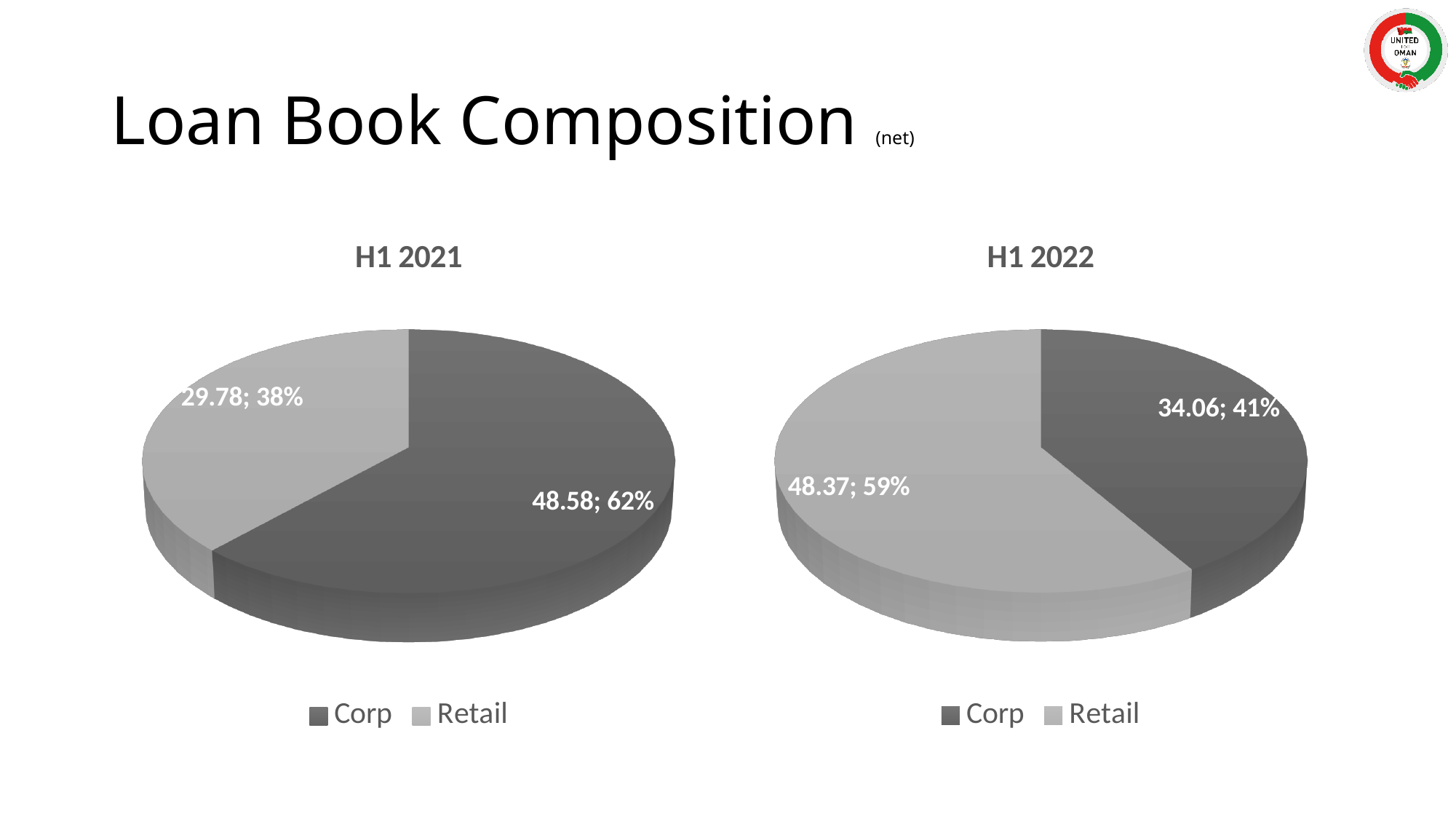
In the H1 2022 chart, is the value for Retail larger or smaller than the value for Corp? larger In the H1 2022 chart, what is the value for Retail? 48.37 In the H1 2022 chart, what share of the pie does Corp represent? 41% What kind of chart is the H1 2022 chart? pie chart How many entries does the legend of the H1 2021 chart list? 2 In the H1 2021 chart, what is the value for Retail? 29.78 In the H1 2021 chart, what is the difference between the Corp and Retail values? 18.80 In the H1 2022 chart, what is the value for Corp? 34.06 In the H1 2021 chart, which category is the largest? Corp In the H1 2021 chart, what is the value for Corp? 48.58 In the H1 2022 chart, which category is the smallest? Corp In the H1 2021 chart, what share of the pie does Retail represent? 38%